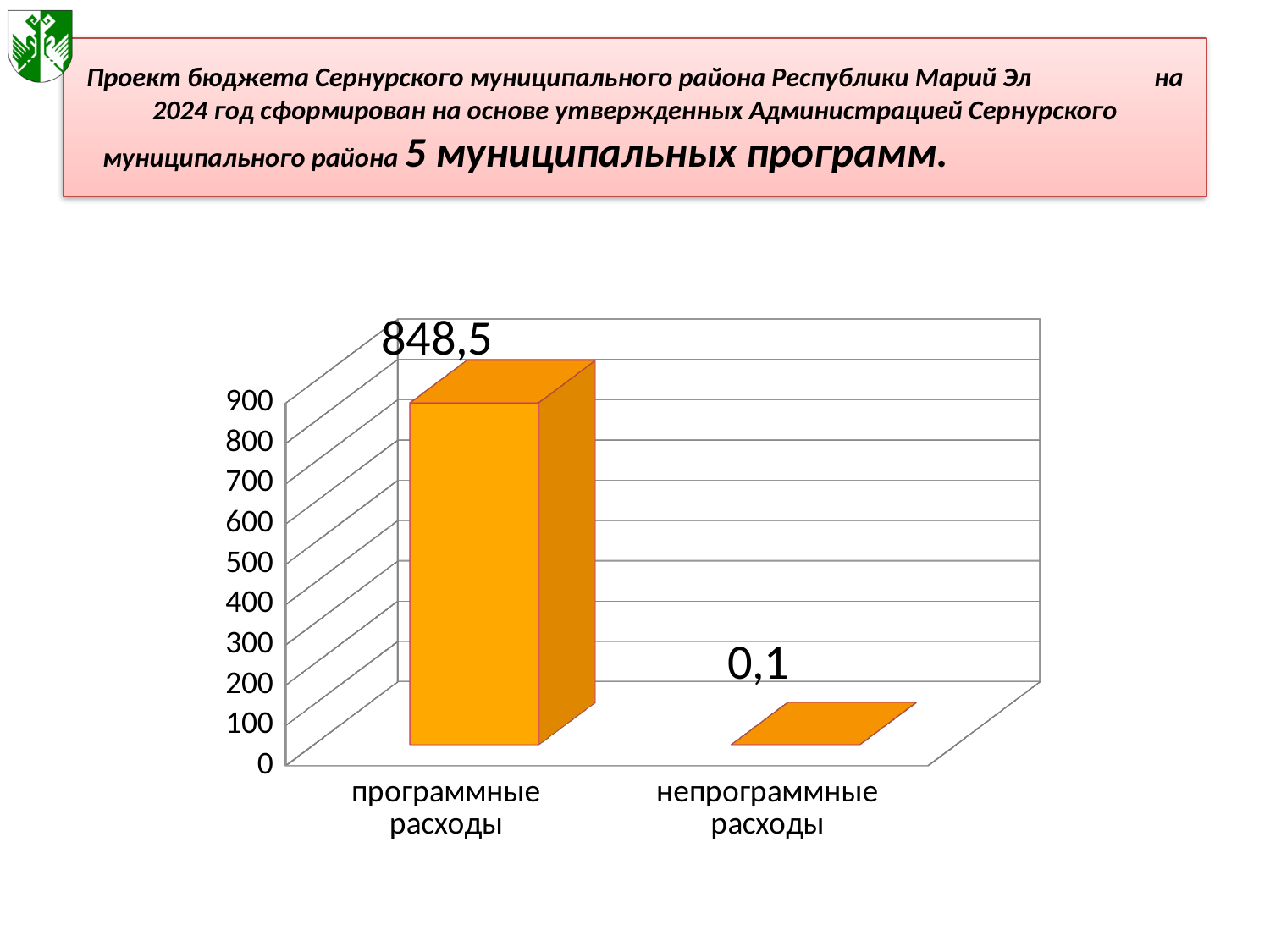
What is the value for непрограммные расходы? 0,1 What kind of chart is shown on the slide? bar chart Which is larger, программные расходы or непрограммные расходы? программные расходы Is the value for программные расходы greater or less than 800? greater What is the highest value shown on the vertical axis? 900 What is the value for программные расходы? 848,5 How many categories are shown in the chart? 2 Which category has the highest value? программные расходы Is the value for непрограммные расходы greater or less than 100? less Which category has the lowest value? непрограммные расходы What colour are the bars in the chart? orange What is the difference between программные расходы and непрограммные расходы? 848,4